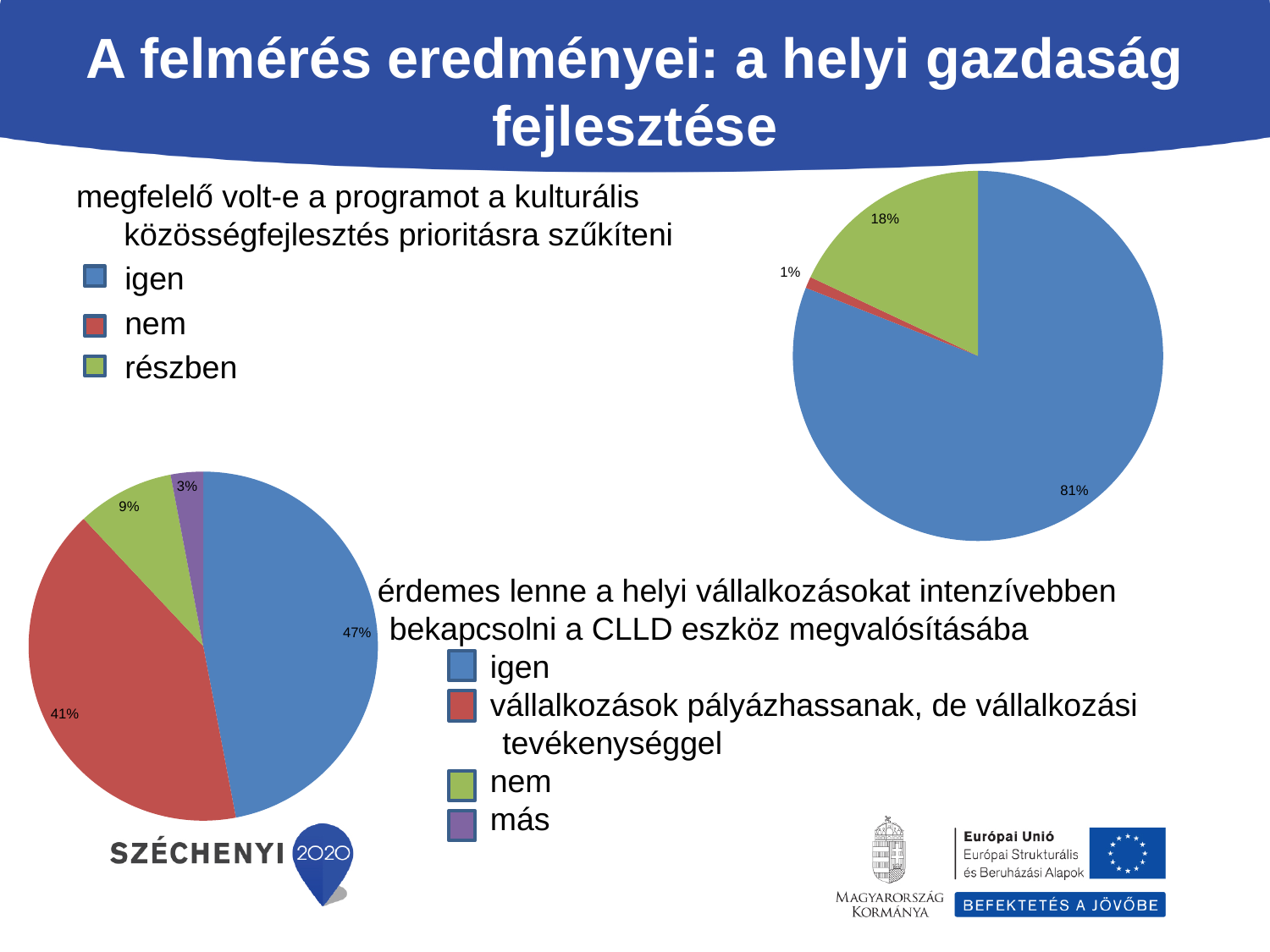
In the pie chart at the top right of the slide, what share of respondents answered "nem"? 1% In the pie chart at the top right of the slide, what share of respondents answered "részben"? 18% How many categories does the legend of the pie chart at the bottom left of the slide list? 4 In the pie chart at the top right of the slide, which answer has the largest share? igen In the pie chart at the bottom left of the slide, what share of respondents answered "nem"? 9% In the pie chart at the top right of the slide, how many percentage points larger is the "igen" share than the "részben" share? 63 In the pie chart at the top right of the slide, what share of respondents answered "igen"? 81% In the pie chart at the bottom left of the slide, what share of respondents answered "igen"? 47% What type of chart is shown at the top right of the slide? pie chart In the pie chart at the bottom left of the slide, what share of respondents answered "más"? 3% In the pie chart at the top right of the slide, which answer has the smallest share? nem In the pie chart at the bottom left of the slide, which is larger: the share for "igen" or the share for "vállalkozások pályázhassanak, de vállalkozási tevékenységgel"? igen